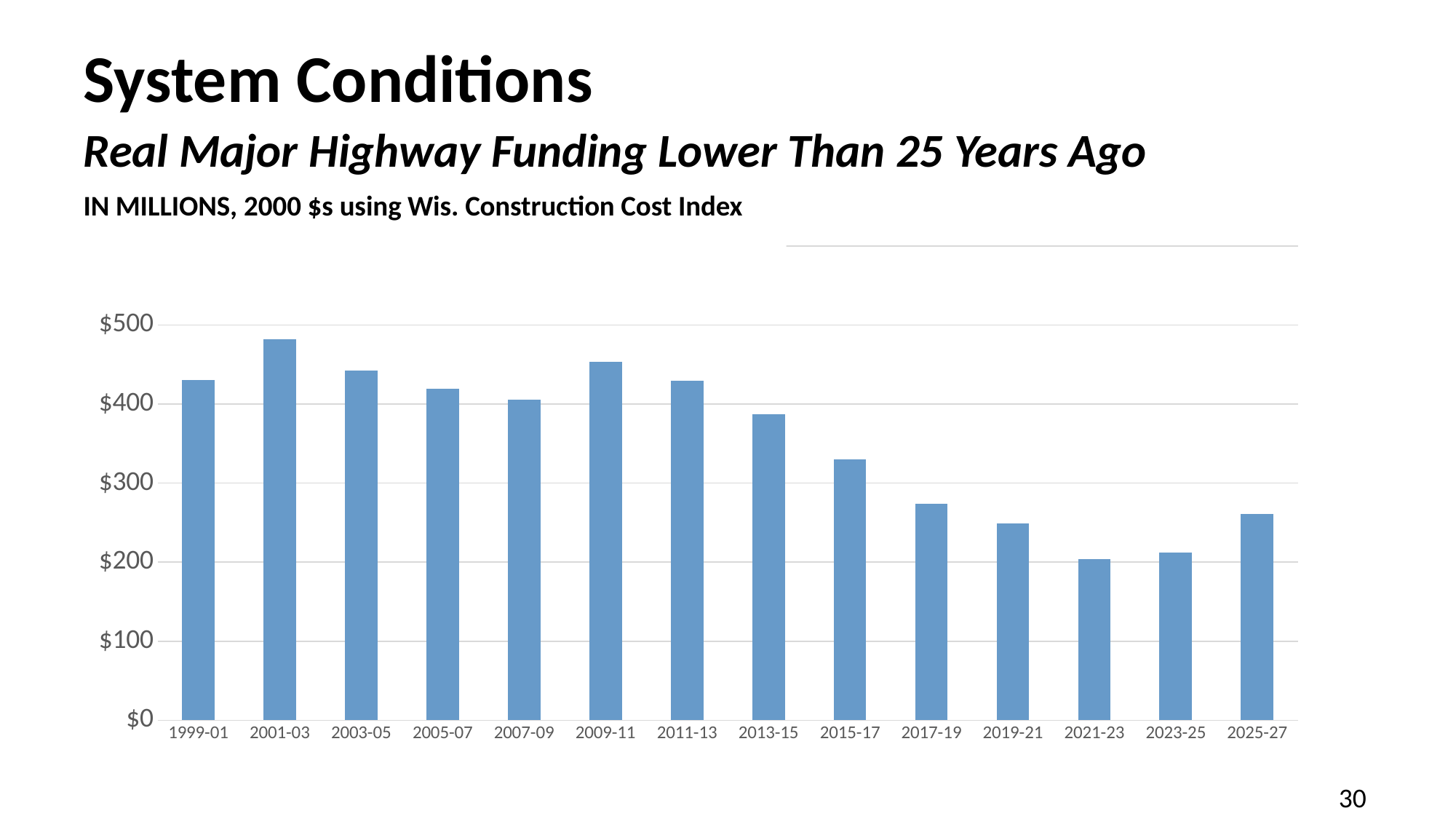
What kind of chart is shown on the slide? bar chart Overall, do the values rise or fall from 1999-01 to 2025-27? fall Is the value for 2013-15 greater or less than $400? less Is the value for 2009-11 greater or less than $400? greater Which biennium has the lowest real major highway funding? 2021-23 How many biennia (bars) are shown on the chart? 14 Is the value for 2015-17 greater or less than $300? greater In what units are the chart values expressed, according to the subtitle? Millions, 2000 $s using Wis. Construction Cost Index Which biennium has the highest real major highway funding? 2001-03 Which is larger, the value for 2009-11 or the value for 2013-15? 2009-11